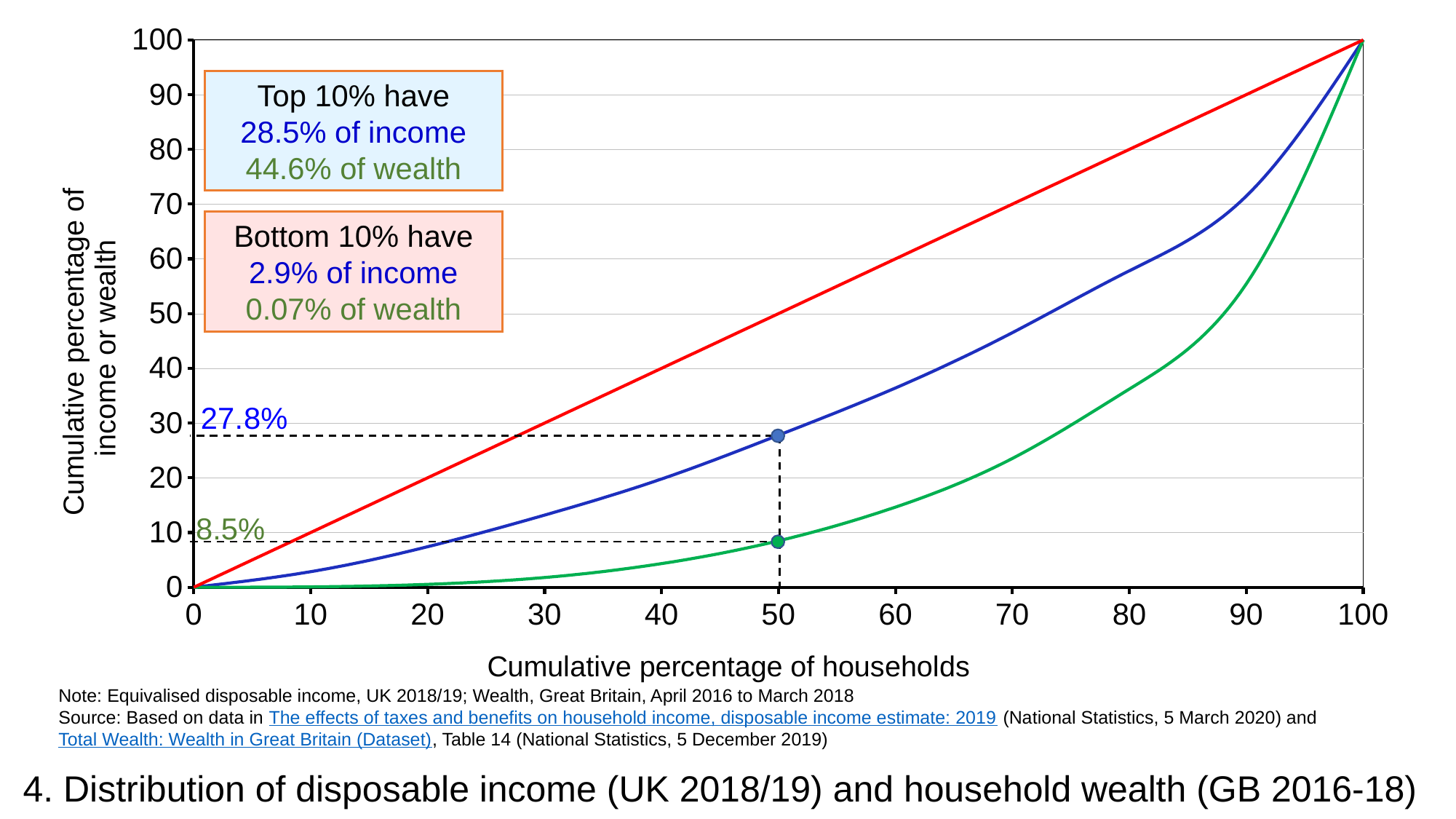
Do the blue and green curves rise or fall as the cumulative percentage of households increases? Rise Is the cumulative percentage of wealth at 80% of households greater or less than 40? less What is the label on the x axis of the chart? Cumulative percentage of households According to the annotation box, what share of wealth do the top 10% have? 44.6% What is the cumulative percentage of wealth held by the bottom 50% of households, as labelled on the chart? 8.5% At 50% of households, which is larger: the cumulative share of income or the cumulative share of wealth? Income What is the difference between the cumulative income share (27.8%) and the cumulative wealth share (8.5%) at 50% of households? 19.3 percentage points According to the annotation box, what share of income do the top 10% have? 28.5% What type of chart is shown on the slide? Line chart What is the cumulative percentage of income held by the bottom 50% of households, as labelled on the chart? 27.8% According to the annotation box, what share of wealth do the bottom 10% have? 0.07% According to the annotation box, what share of income do the bottom 10% have? 2.9%